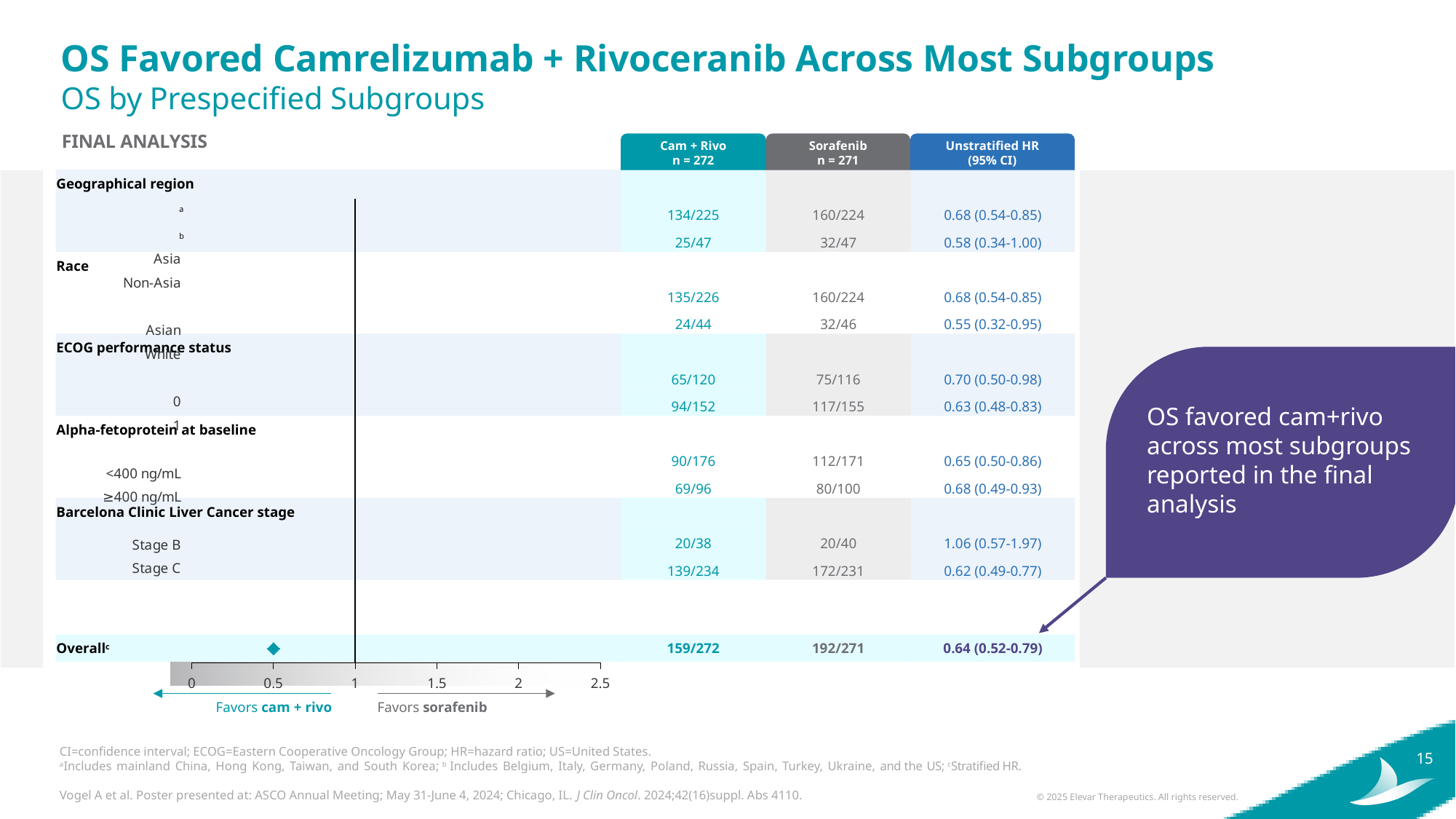
Which is larger, the hazard ratio for Stage B or for Stage C? Stage B Which subgroup has the highest hazard ratio in the table? Stage B How many prespecified subgroup categories (bold headings) are listed in the plot? 5 What is the unstratified HR (95% CI) for the Overall row? 0.64 (0.52-0.79) Is the Overall hazard ratio diamond plotted at a value greater or less than 1? less What is the HR (95% CI) for Barcelona Clinic Liver Cancer Stage C? 0.62 (0.49-0.77) What is the sample size (n) for the Cam + Rivo arm shown in the column header? 272 What is the Cam + Rivo events/patients value for the Overall row? 159/272 Which treatment is favored by hazard ratios to the left of 1 on the axis? cam + rivo What is the maximum value shown on the hazard ratio axis? 2.5 What is the Sorafenib events/patients value for the Overall row? 192/271 What is the HR (95% CI) for Barcelona Clinic Liver Cancer Stage B? 1.06 (0.57-1.97)